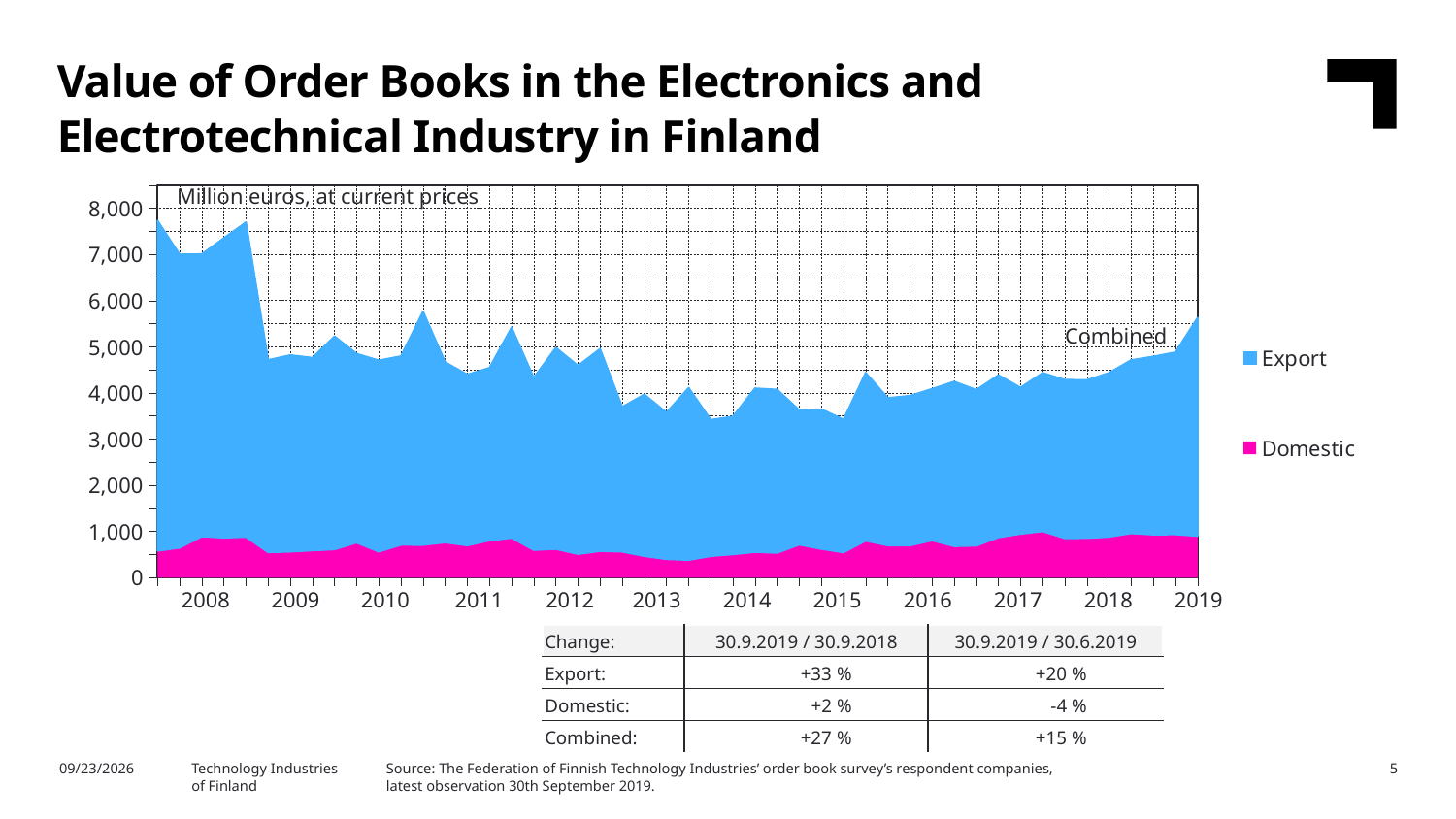
Is the combined value at the end of the series in 2019 greater or less than 5,000? greater What unit is stated at the top of the chart? Million euros, at current prices Which two series are listed in the chart legend? Export and Domestic How many series does the legend list? 2 Is the combined value at the start of 2008 greater or less than 7,000? greater Is the combined value in 2014 greater or less than 5,000? less Does the combined value generally rise or fall from 2008 to 2014? fall What kind of chart is shown on the slide? Area chart How many year labels are shown on the x axis? 12 In which year does the combined value reach its highest level? 2008 Which series is larger throughout the chart, Export or Domestic? Export